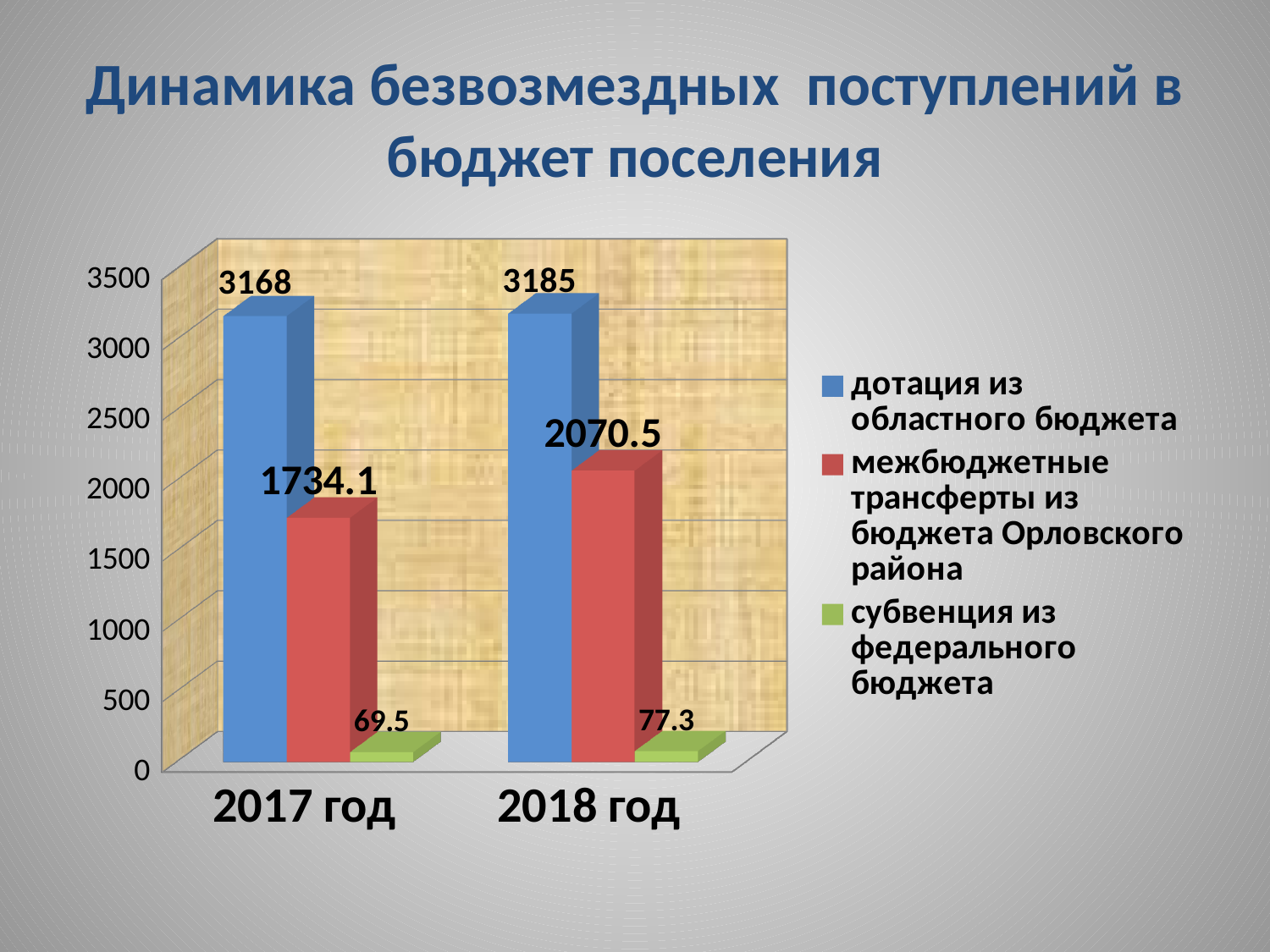
Which is larger: дотация из областного бюджета in 2017 год or in 2018 год? 2018 год Which series has the highest value in 2018 год? дотация из областного бюджета What is the difference between the межбюджетные трансферты из бюджета Орловского района values for 2018 год and 2017 год? 336.4 What is the value of субвенция из федерального бюджета for 2018 год? 77.3 Which series has the lowest value in 2017 год? субвенция из федерального бюджета What is the value of межбюджетные трансферты из бюджета Орловского района for 2018 год? 2070.5 Does the value of межбюджетные трансферты из бюджета Орловского района rise or fall from 2017 год to 2018 год? rise How many categories are shown on the x axis? 2 What kind of chart is shown on the slide? bar chart What is the value of субвенция из федерального бюджета for 2017 год? 69.5 How many series does the legend list? 3 What is the value of дотация из областного бюджета for 2017 год? 3168